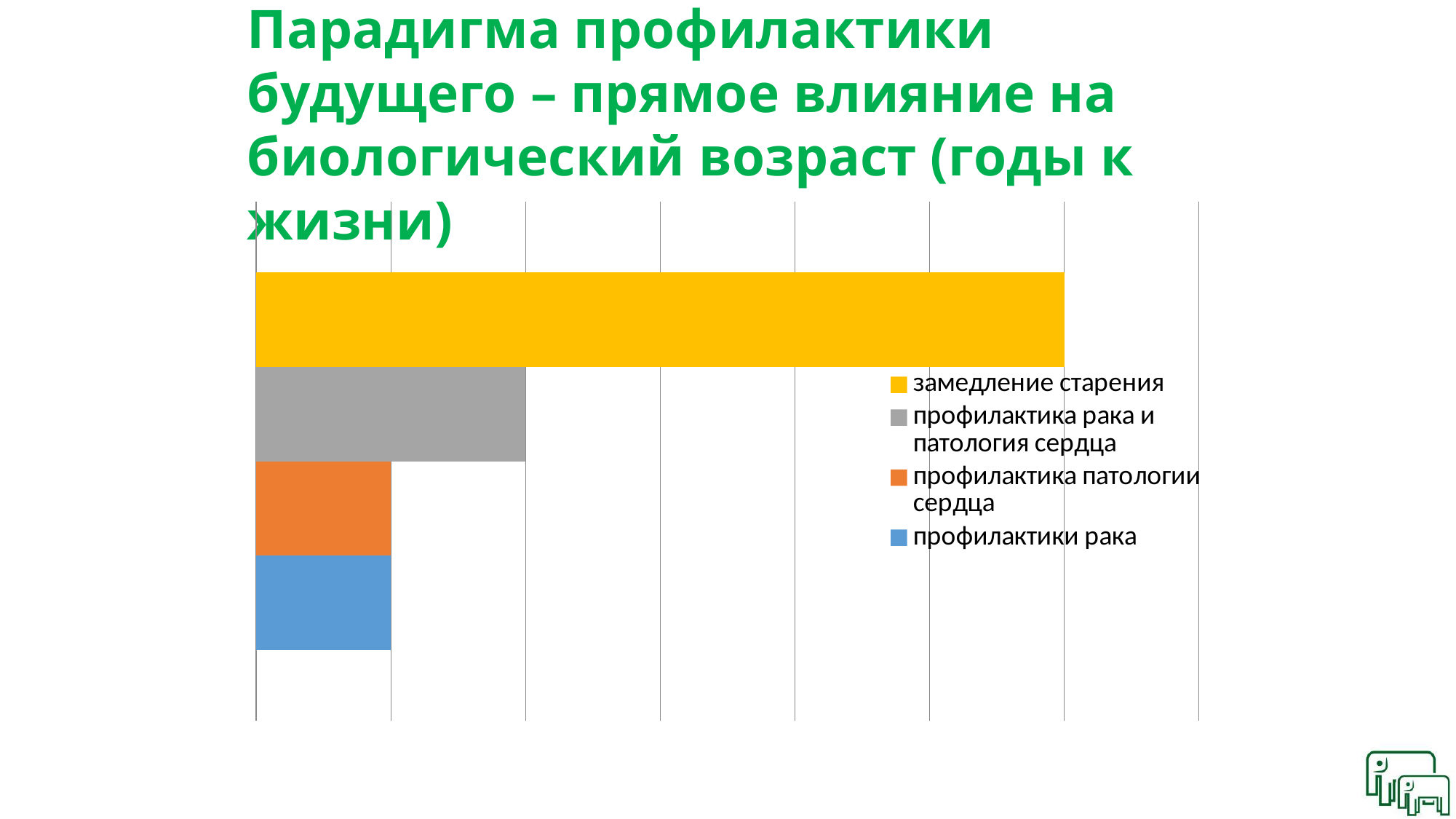
Which bar is longer: замедление старения or профилактики рака? замедление старения What kind of chart is shown on the slide? Bar chart How many bars are plotted in the chart? 4 Which series is shown in blue in the legend? профилактики рака Which bar is longer: профилактика рака и патология сердца or профилактика патологии сердца? профилактика рака и патология сердца How many series does the legend list? 4 Which series has the longest bar? замедление старения Which bar is longer: профилактика рака и патология сердца or профилактики рака? профилактика рака и патология сердца What colour is the bar for замедление старения? Yellow